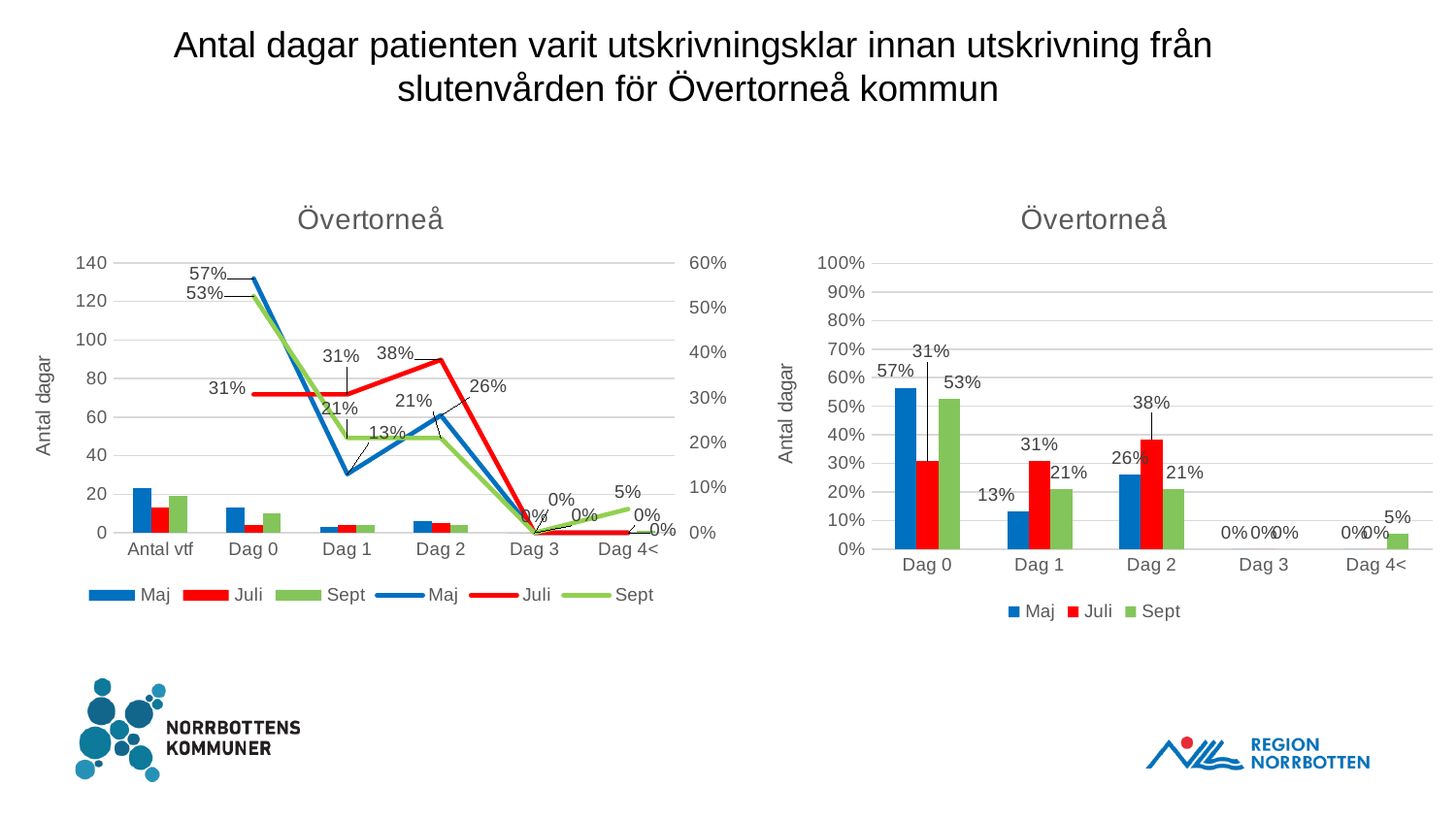
In the left-hand chart, what is the label on the left vertical axis? Antal dagar In the right-hand chart, what is the value for Juli at Dag 2? 38% In the right-hand chart, what is the value for Maj at Dag 0? 57% In the left-hand chart, is the Maj bar for Antal vtf greater or less than 20? greater In the right-hand chart, what is the value for Sept at Dag 4<? 5% In the right-hand chart, what is the difference between Maj and Sept at Dag 0? 4% In the right-hand chart, which series has the highest value at Dag 1? Juli In the right-hand chart, which is larger at Dag 2: Maj or Juli? Juli In the right-hand chart, how many categories are shown on the x axis? 5 In the right-hand chart, which series has the lowest value at Dag 0? Juli What kind of chart is the right-hand chart? Bar chart How many series does the legend of the right-hand chart list? 3